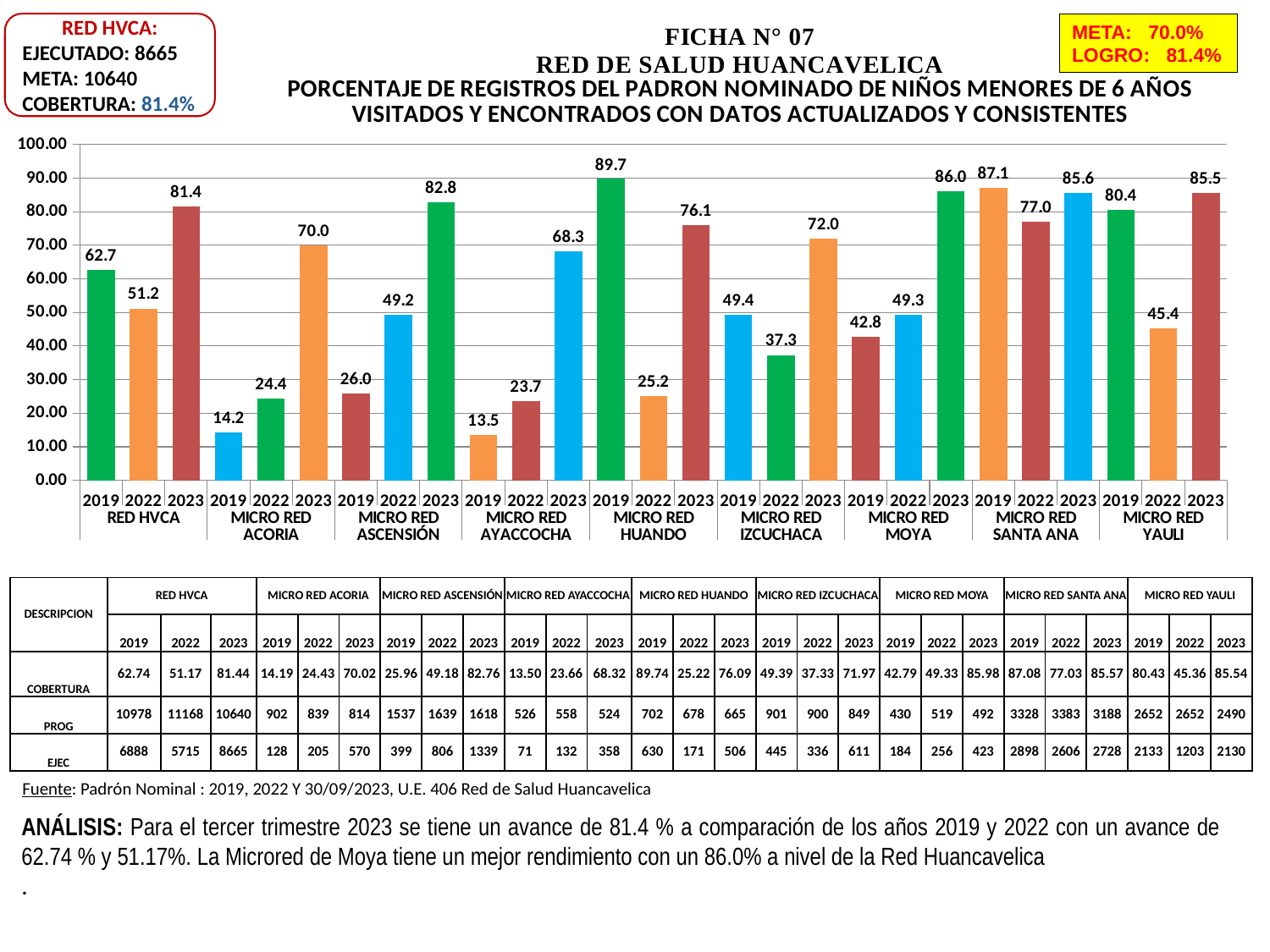
What kind of chart is shown on the slide? Bar chart Which is larger in 2023: MICRO RED ASCENSIÓN or MICRO RED SANTA ANA? MICRO RED SANTA ANA Which bar has the lowest value in the chart? MICRO RED AYACCOCHA 2019 (13.5) What is the difference between the 2023 and 2022 values for RED HVCA? 30.2 What is the value for RED HVCA in 2023? 81.4 Do the values for MICRO RED ACORIA rise or fall from 2019 to 2023? Rise Which bar has the highest value in the chart? MICRO RED HUANDO 2019 (89.7) What is the value for MICRO RED MOYA in 2023? 86.0 What is the maximum value shown on the y axis? 100.00 What is the difference between the 2019 and 2022 values for MICRO RED HUANDO? 64.5 What is the value for MICRO RED IZCUCHACA in 2022? 37.3 How many networks (groups of bars) are shown on the x axis? 9